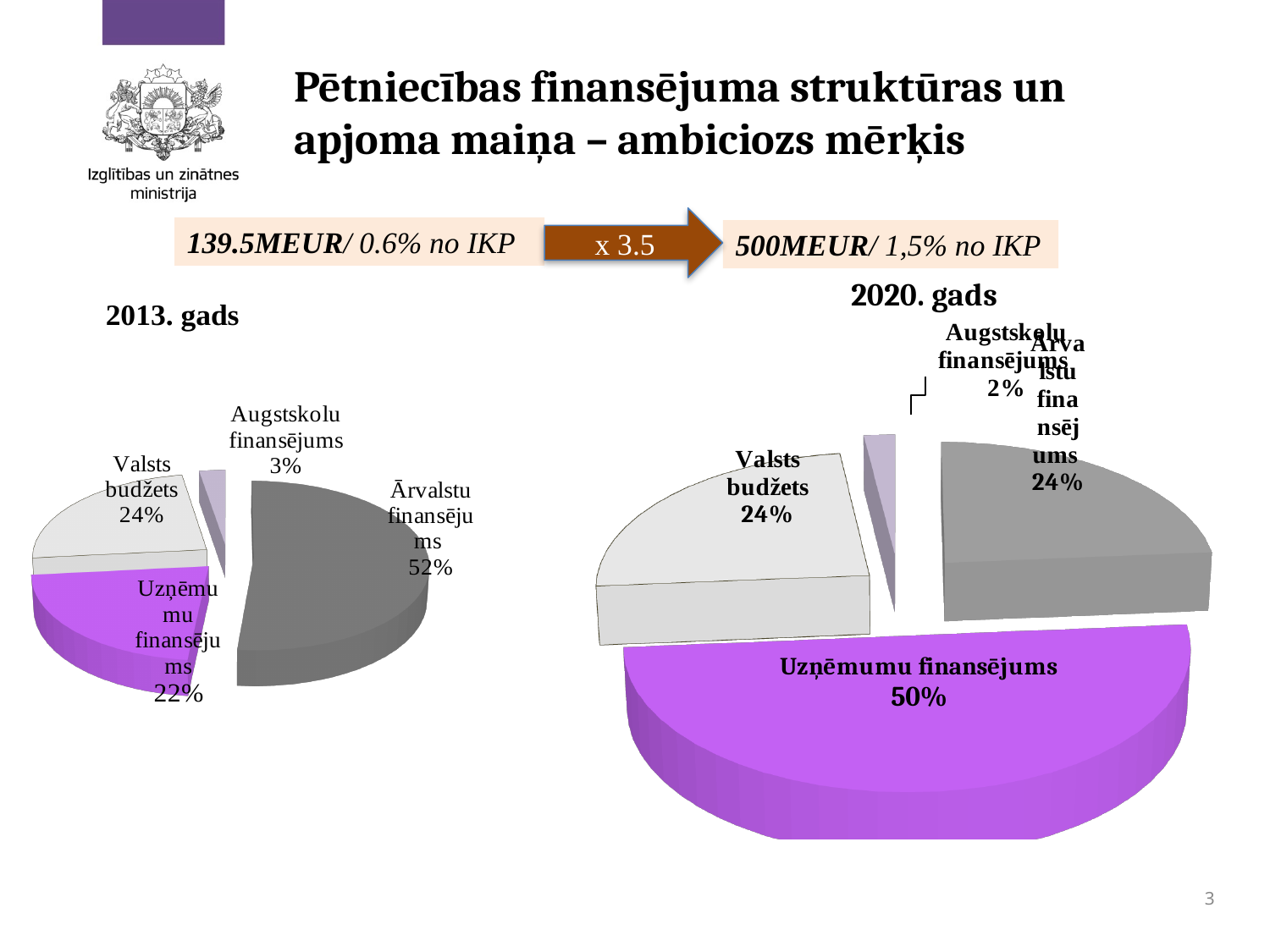
In the 2020. gads pie chart, which category has the largest share? Uzņēmumu finansējums Which is larger: the share of Ārvalstu finansējums in the 2013. gads chart or in the 2020. gads chart? 2013. gads In the 2013. gads pie chart, what is the combined share of Valsts budžets and Uzņēmumu finansējums? 46% In the 2013. gads pie chart, which category has the largest share? Ārvalstu finansējums In the 2013. gads pie chart, which category has the smallest share? Augstskolu finansējums In the 2013. gads pie chart, how many slices are there? 4 In the 2020. gads pie chart, what is the difference between the shares of Uzņēmumu finansējums and Valsts budžets? 26 percentage points In the 2013. gads pie chart, what share does Uzņēmumu finansējums have? 22% In the 2020. gads pie chart, what share does Uzņēmumu finansējums have? 50% What type of chart is used for the 2020. gads data? Pie chart In the 2020. gads pie chart, what share does Augstskolu finansējums have? 2% In the 2013. gads pie chart, what share does Ārvalstu finansējums have? 52%